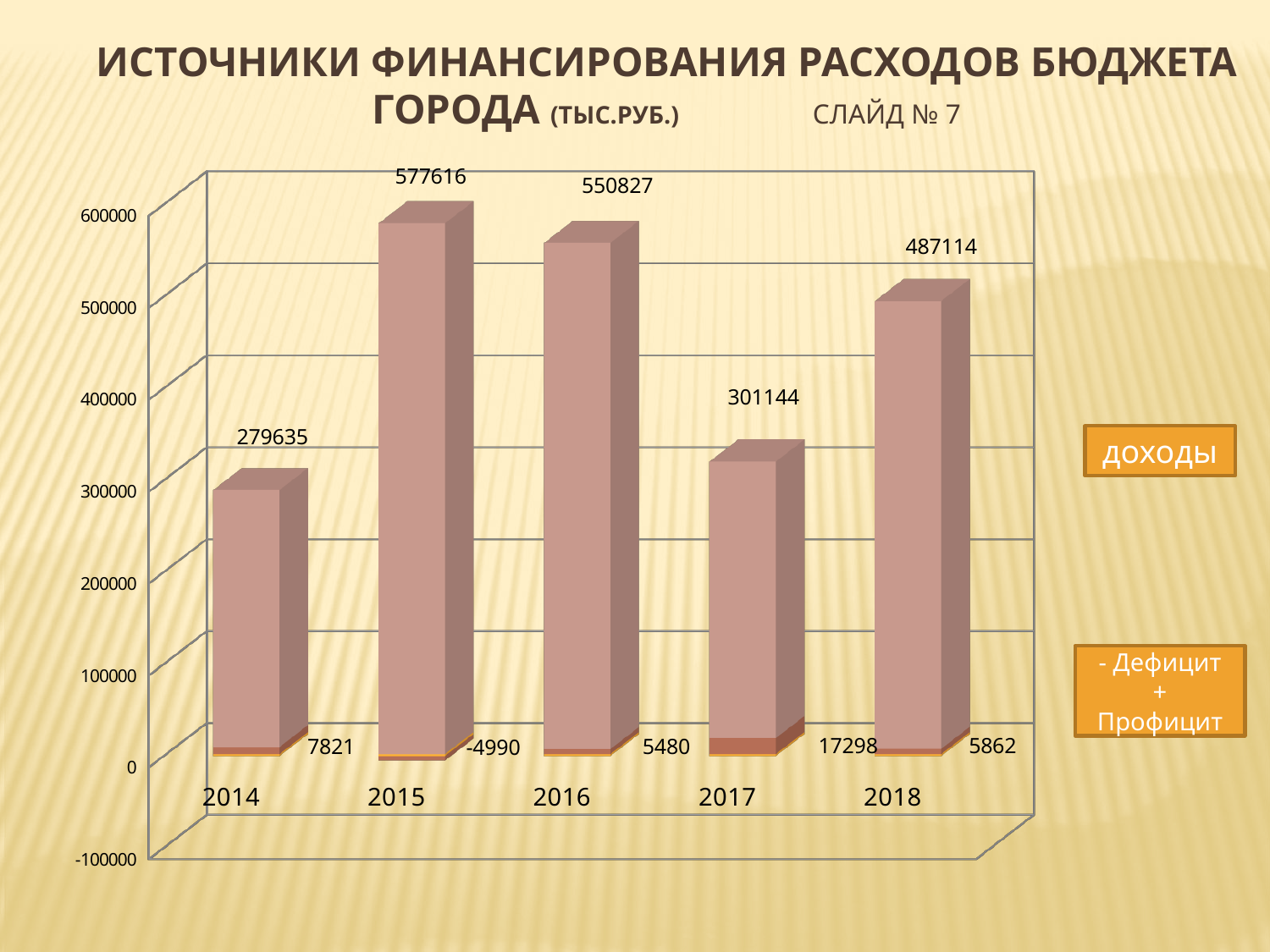
How many series does the legend list? 2 Which year has the highest ДОХОДЫ value? 2015 Which year has the lowest ДОХОДЫ value? 2014 What unit is given in the chart title? ТЫС.РУБ. What is the ДОХОДЫ value for 2018? 487114 What is the Дефицит/Профицит value for 2017? 17298 How many years are shown on the x axis? 5 What is the ДОХОДЫ value for 2015? 577616 What is the Дефицит/Профицит value for 2015? -4990 Which is larger, the ДОХОДЫ value for 2017 or for 2018? 2018 What kind of chart is shown on the slide? bar chart What is the difference between the ДОХОДЫ values for 2015 and 2016? 26789